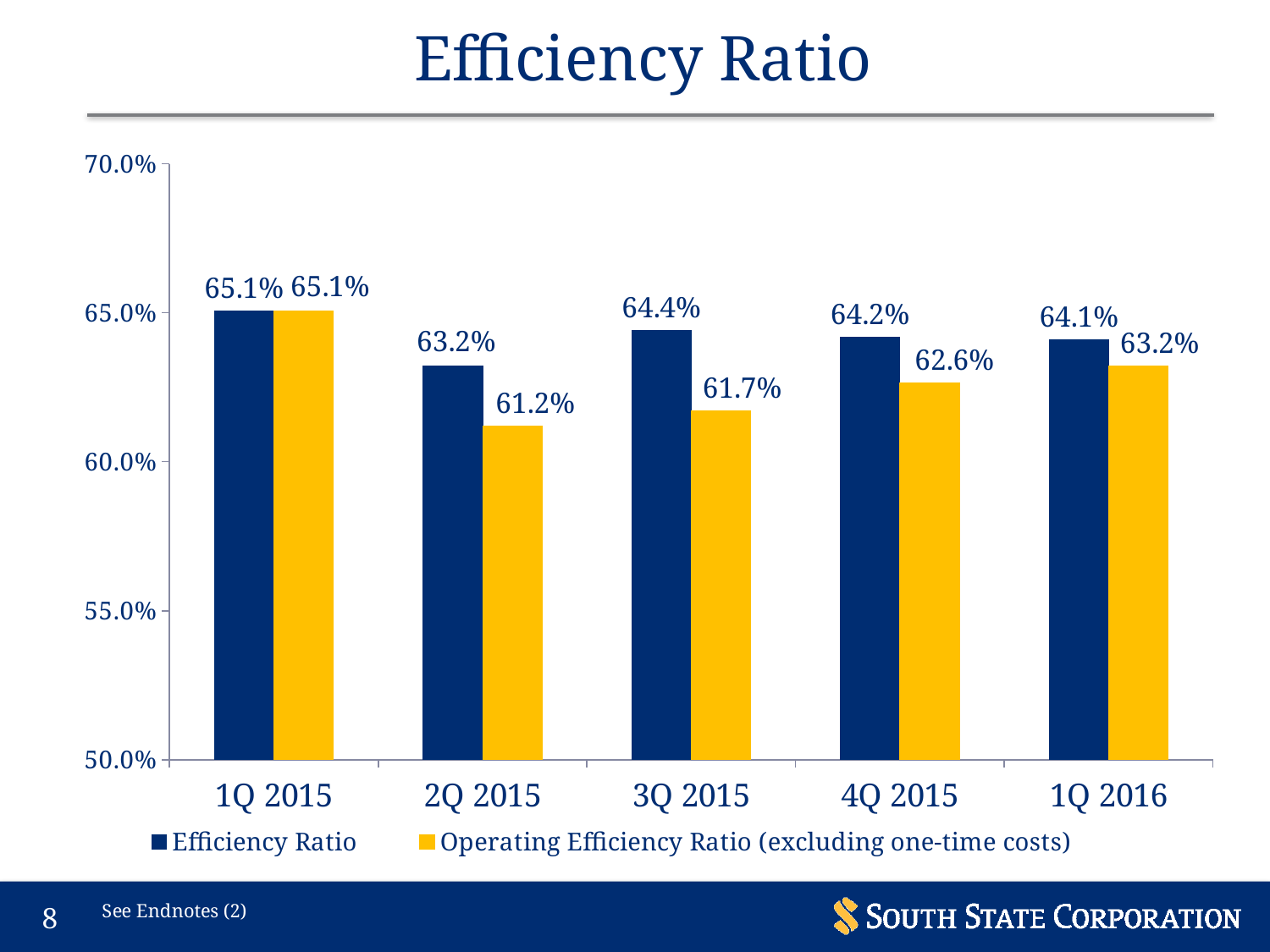
Which is larger in 3Q 2015: the Efficiency Ratio or the Operating Efficiency Ratio (excluding one-time costs)? Efficiency Ratio What kind of chart is shown on the slide? Bar chart What is the Operating Efficiency Ratio (excluding one-time costs) for 2Q 2015? 61.2% Which quarter has the lowest Operating Efficiency Ratio (excluding one-time costs)? 2Q 2015 Does the Efficiency Ratio rise or fall from 3Q 2015 to 1Q 2016? Fall Which quarter has the highest Efficiency Ratio? 1Q 2015 What is the Efficiency Ratio for 3Q 2015? 64.4% What is the Operating Efficiency Ratio (excluding one-time costs) for 1Q 2016? 63.2% What is the difference between the Efficiency Ratio and the Operating Efficiency Ratio (excluding one-time costs) in 4Q 2015? 1.6% How many series does the legend list? 2 What is the title of the chart? Efficiency Ratio How many quarters are shown on the x axis? 5